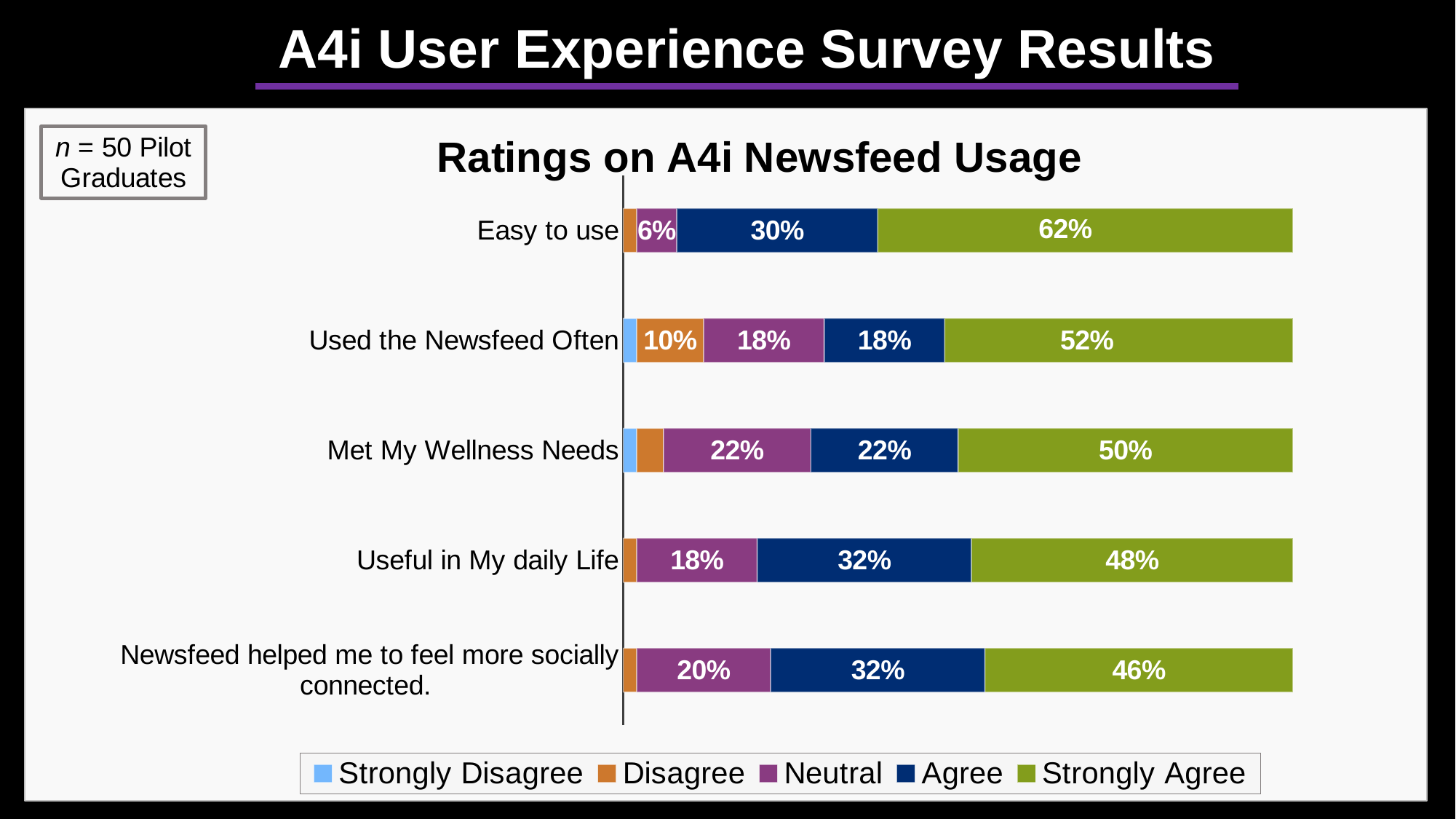
Which is larger: the Agree value for "Easy to use" or the Agree value for "Met My Wellness Needs"? Easy to use What is the Neutral value for "Newsfeed helped me to feel more socially connected."? 20% Which statement has the lowest Strongly Agree percentage? Newsfeed helped me to feel more socially connected. What type of chart is shown on the slide? Stacked bar chart What is the Agree value for "Useful in My daily Life"? 32% What is the Disagree value for "Used the Newsfeed Often"? 10% Which statement has the highest Strongly Agree percentage? Easy to use What is the title of the chart? Ratings on A4i Newsfeed Usage How many response categories does the legend list? 5 How many statements are rated in the chart? 5 What percentage of respondents strongly agreed that the A4i newsfeed was easy to use? 62% What is the difference between the Strongly Agree values for "Easy to use" and "Used the Newsfeed Often"? 10%